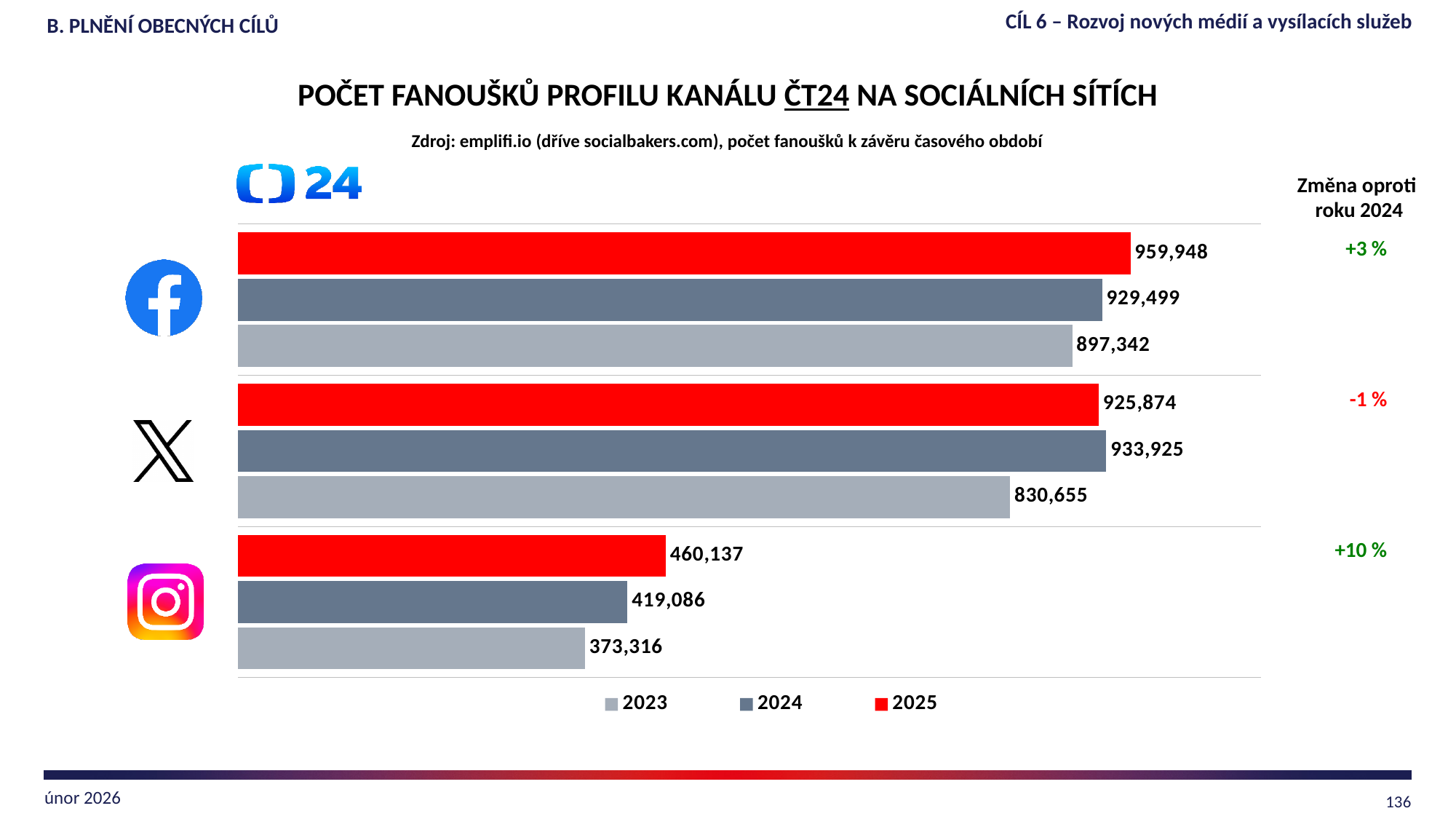
How many series does the legend list? 3 Which is larger: X fans in 2024 or X fans in 2025? X fans in 2024 What is the number of X (Twitter) fans in 2024? 933,925 What kind of chart is shown on the slide? bar chart Which colour represents the year 2025 in the legend? red Do the Instagram values rise or fall from 2023 to 2025? rise What is the number of Facebook fans in 2025? 959,948 Which social network has the highest number of fans in 2025? Facebook What is the number of Instagram fans in 2023? 373,316 Which bar shows the lowest value in the whole chart? Instagram 2023 (373,316) How many social networks (categories) are shown in the chart? 3 By how much did the number of Facebook fans increase from 2024 to 2025? 30,449